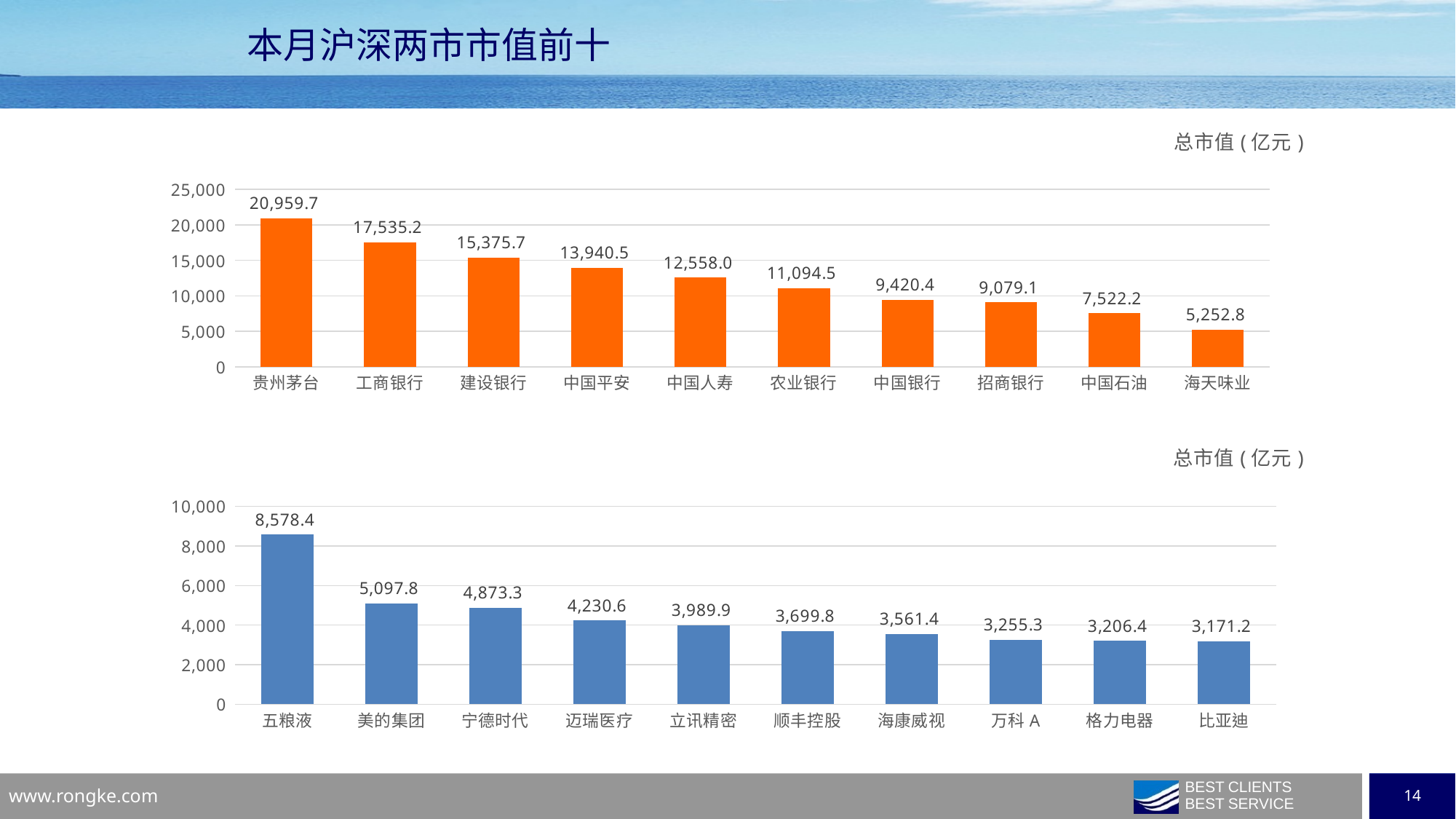
In the bottom chart, do the values rise or fall from left to right? fall In the top chart, how many categories are shown? 10 In the bottom chart, which category has the highest value? 五粮液 In the top chart, what is the value for 中国平安? 13,940.5 In the bottom chart, what is the value for 海康威视? 3,561.4 In the top chart, which is larger, the value for 中国银行 or the value for 招商银行? 中国银行 In the top chart, what is the value for 贵州茅台? 20,959.7 In the bottom chart, what is the value for 五粮液? 8,578.4 In the top chart, what is the difference between the values for 贵州茅台 and 工商银行? 3,424.5 In the bottom chart, what is the difference between the values for 五粮液 and 美的集团? 3,480.6 What kind of chart is the bottom chart? bar chart In the top chart, which category has the lowest value? 海天味业